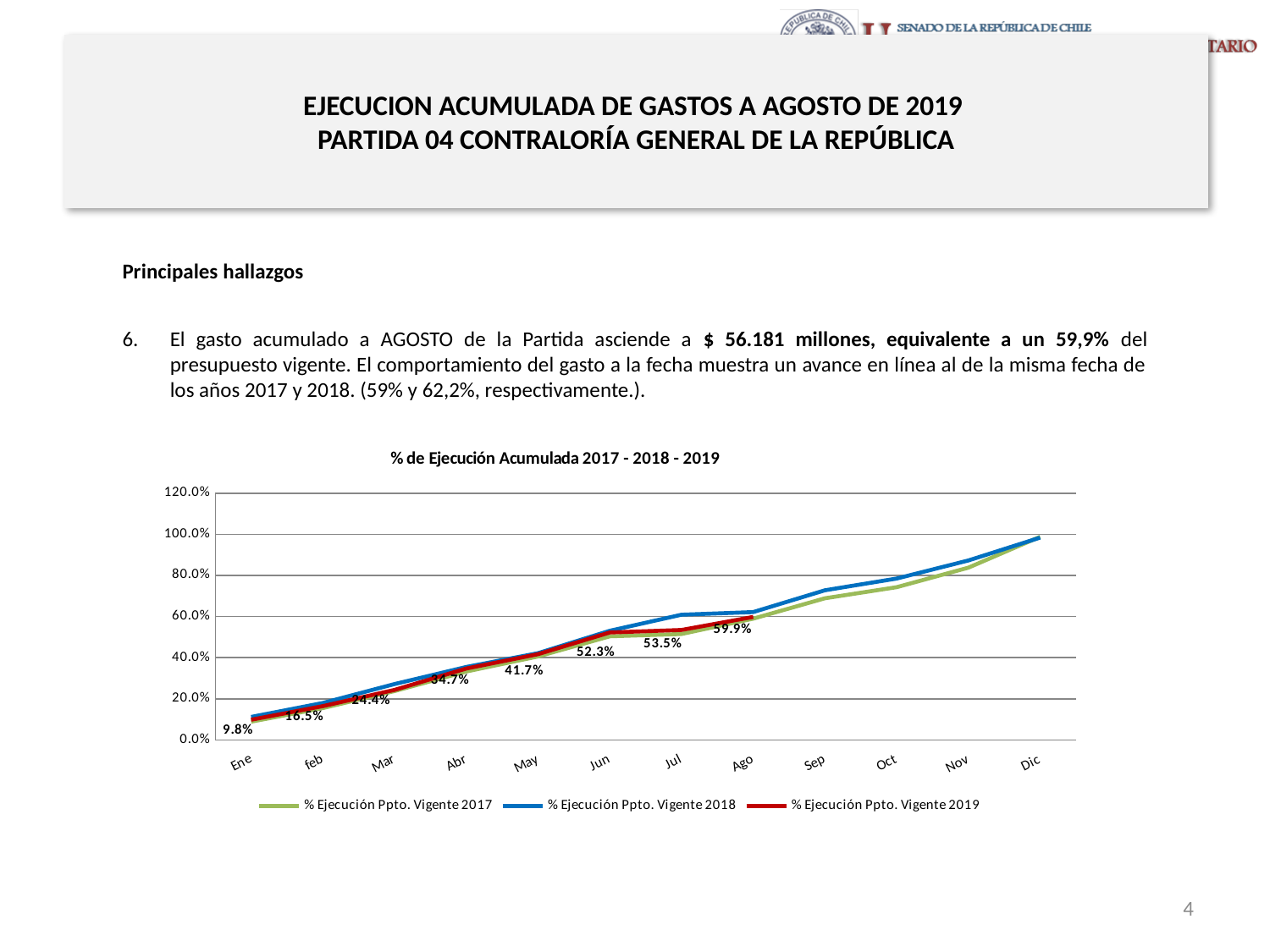
What is the value of % Ejecución Ppto. Vigente 2019 for Ago? 59.9% Which month has the lowest value for % Ejecución Ppto. Vigente 2019? Ene Do the values of % Ejecución Ppto. Vigente 2019 rise or fall from Ene to Ago? rise What is the value of % Ejecución Ppto. Vigente 2019 for Ene? 9.8% Is the value of % Ejecución Ppto. Vigente 2018 for Dic greater or less than 80.0%? greater What is the title of the chart? % de Ejecución Acumulada 2017 - 2018 - 2019 How many months are shown on the x axis? 12 Which month has the highest value for % Ejecución Ppto. Vigente 2019? Ago How many series does the legend list? 3 What type of chart is shown on the slide? line chart What is the difference between the 2019 values for Ago and Jul? 6.4% What is the value of % Ejecución Ppto. Vigente 2019 for Abr? 34.7%